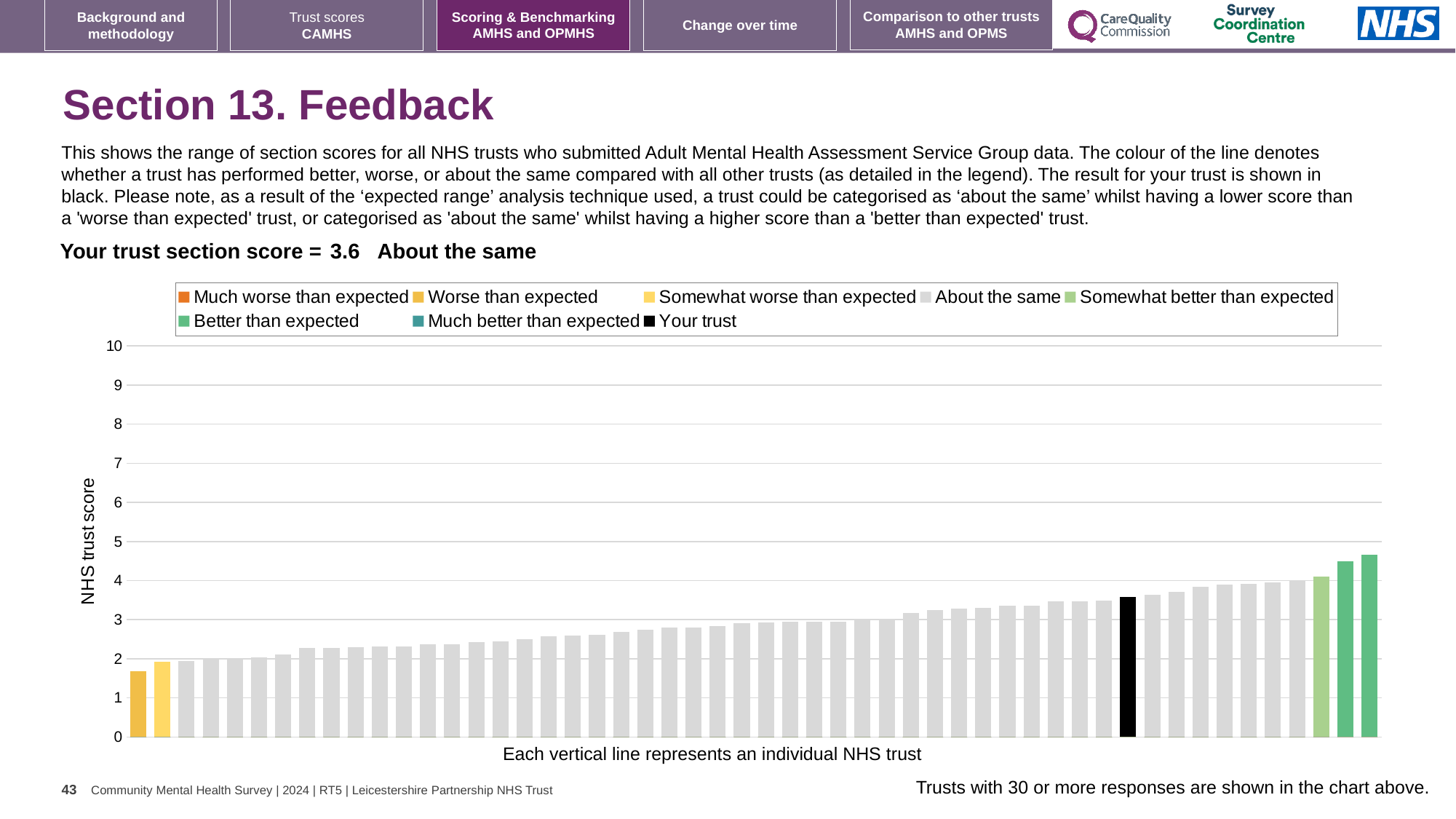
Which is larger: the value for your trust (black bar) or the value of the leftmost bar? your trust Is the value of the tallest bar (rightmost) greater or less than 4? greater What is the section score for your trust shown on the slide? 3.6 Is the value for your trust (the black bar) greater or less than 3? greater Which legend category does the shortest bar in the chart belong to? Worse than expected Which legend category does the tallest bar in the chart belong to? Better than expected Do the bar values rise or fall from left to right along the x axis? rise How many entries does the chart legend list? 8 What is the label on the vertical axis of the chart? NHS trust score What kind of chart is shown on the slide? bar chart Is the value for your trust (the black bar) greater or less than 4? less